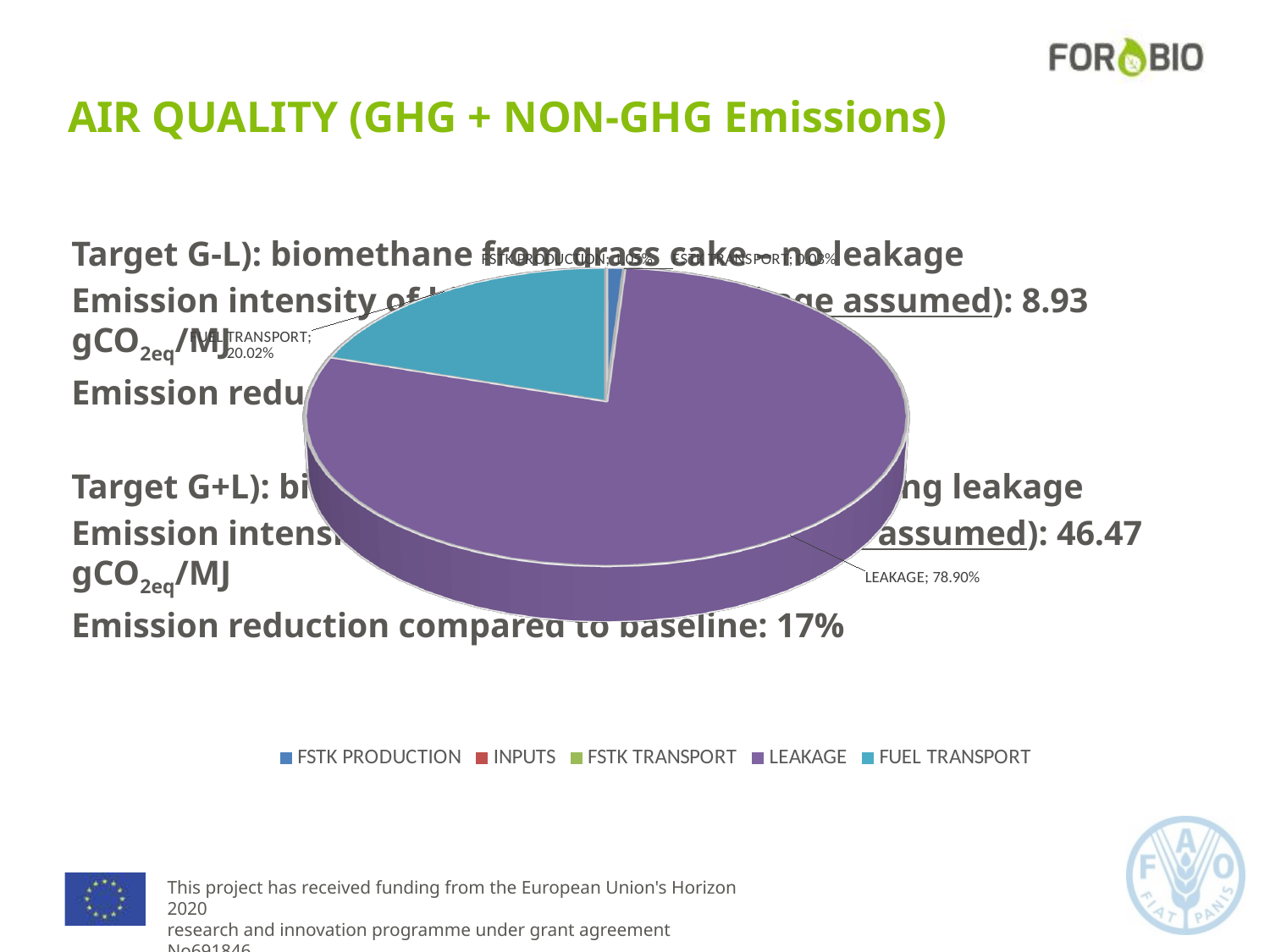
What share of the pie does LEAKAGE account for? 78.90% What is the difference in percentage points between the LEAKAGE share (78.90%) and the FUEL TRANSPORT share (20.02%)? 58.88% What kind of chart is shown on the slide? pie chart What share of the pie does FUEL TRANSPORT account for? 20.02% How many categories does the legend of the pie chart list? 5 Which category is listed first in the legend of the pie chart? FSTK PRODUCTION Which is larger, the LEAKAGE slice or the FUEL TRANSPORT slice? LEAKAGE Does LEAKAGE account for more or less than half of the pie? more What colour is used for the LEAKAGE slice in the pie chart? purple Which category has the largest slice of the pie? LEAKAGE